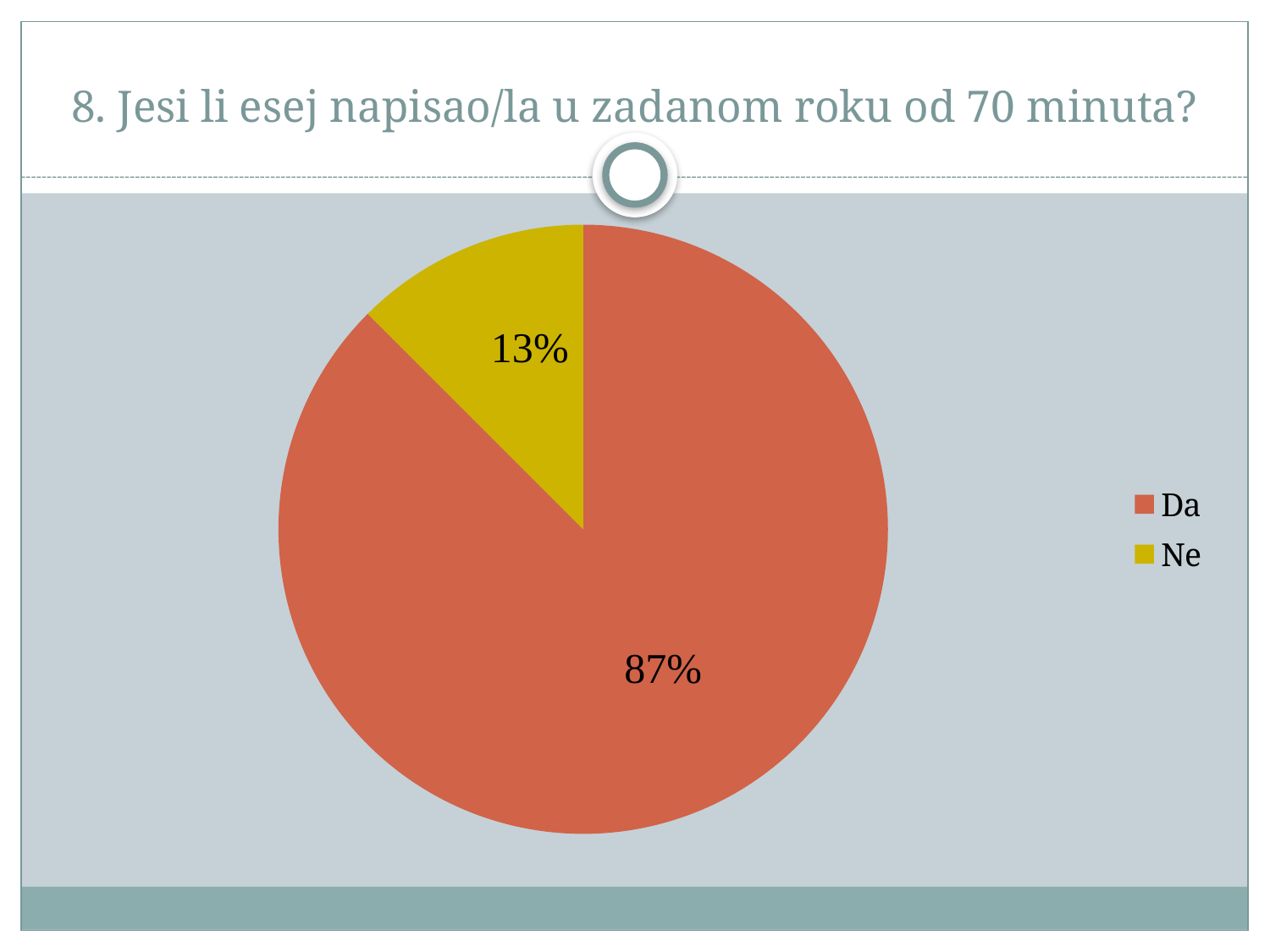
Which slice of the pie is the smallest? Ne How many slices does the pie chart have? 2 What colour is the "Ne" slice of the pie chart? yellow How many entries does the legend list? 2 What percentage of the pie is labelled "Da"? 87% What is the title of the slide containing the pie chart? 8. Jesi li esej napisao/la u zadanom roku od 70 minuta? Which slice is larger, "Da" or "Ne"? Da What percentage of the pie is labelled "Ne"? 13% What is the difference in percentage points between the "Da" and "Ne" slices? 74 Which slice of the pie is the largest? Da What share of the pie does the "Da" slice represent? 87% What kind of chart is shown on the slide? pie chart